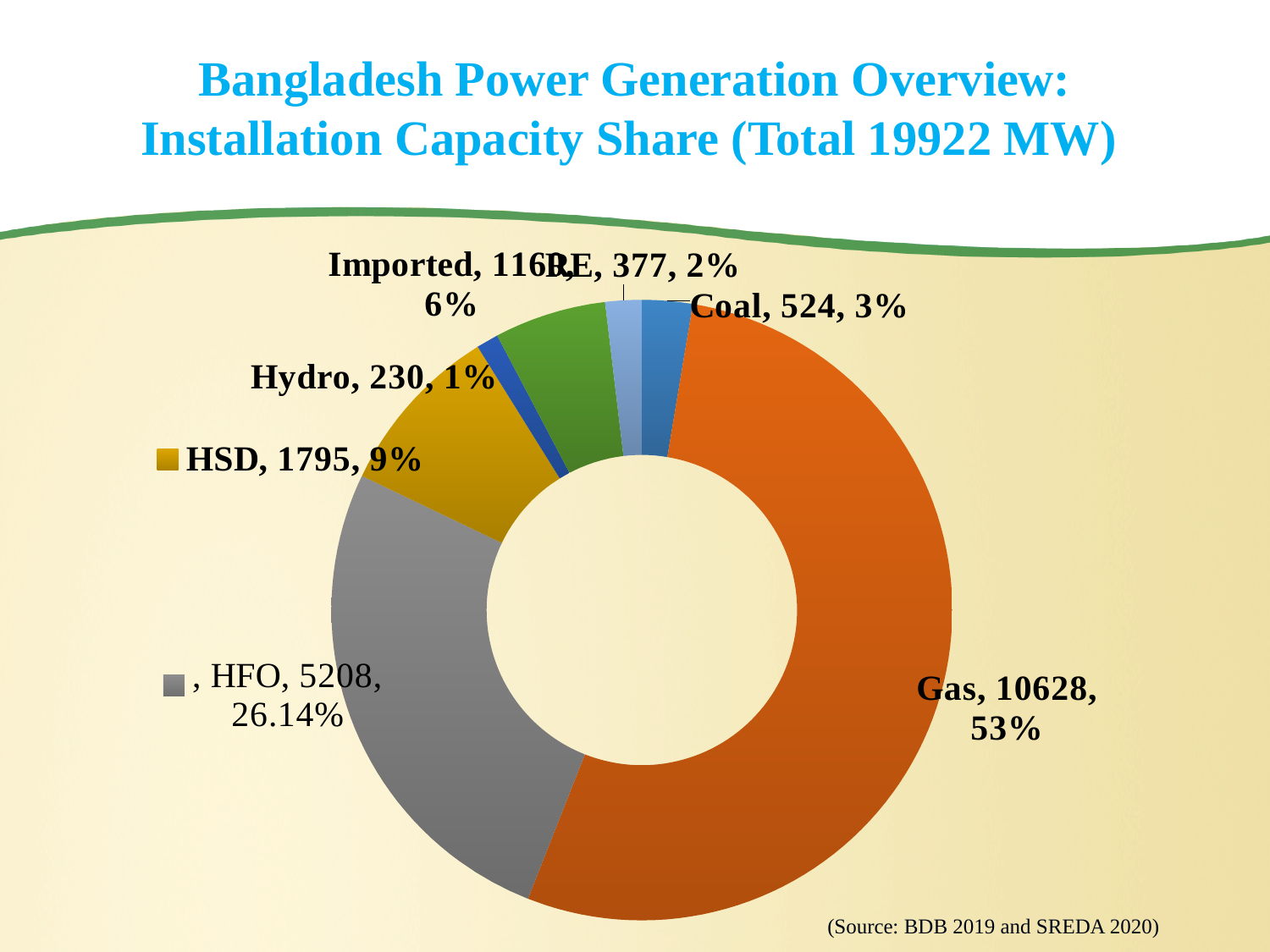
What is the installed capacity value shown for HFO? 5208 Which fuel source has the largest share of installation capacity? Gas What is the installed capacity value shown for HSD? 1795 What percentage share of installation capacity does HFO hold? 26.14% What is the difference between the Gas and HFO capacity values? 5420 What percentage share of installation capacity does Gas hold? 53% What is the installed capacity value shown for Gas? 10628 What is the installed capacity value shown for Coal? 524 Which fuel source has the smallest share of installation capacity? Hydro What is the installed capacity value shown for Hydro? 230 What kind of chart is shown on the slide? Doughnut (pie) chart Which has a larger capacity value, Coal or RE? Coal